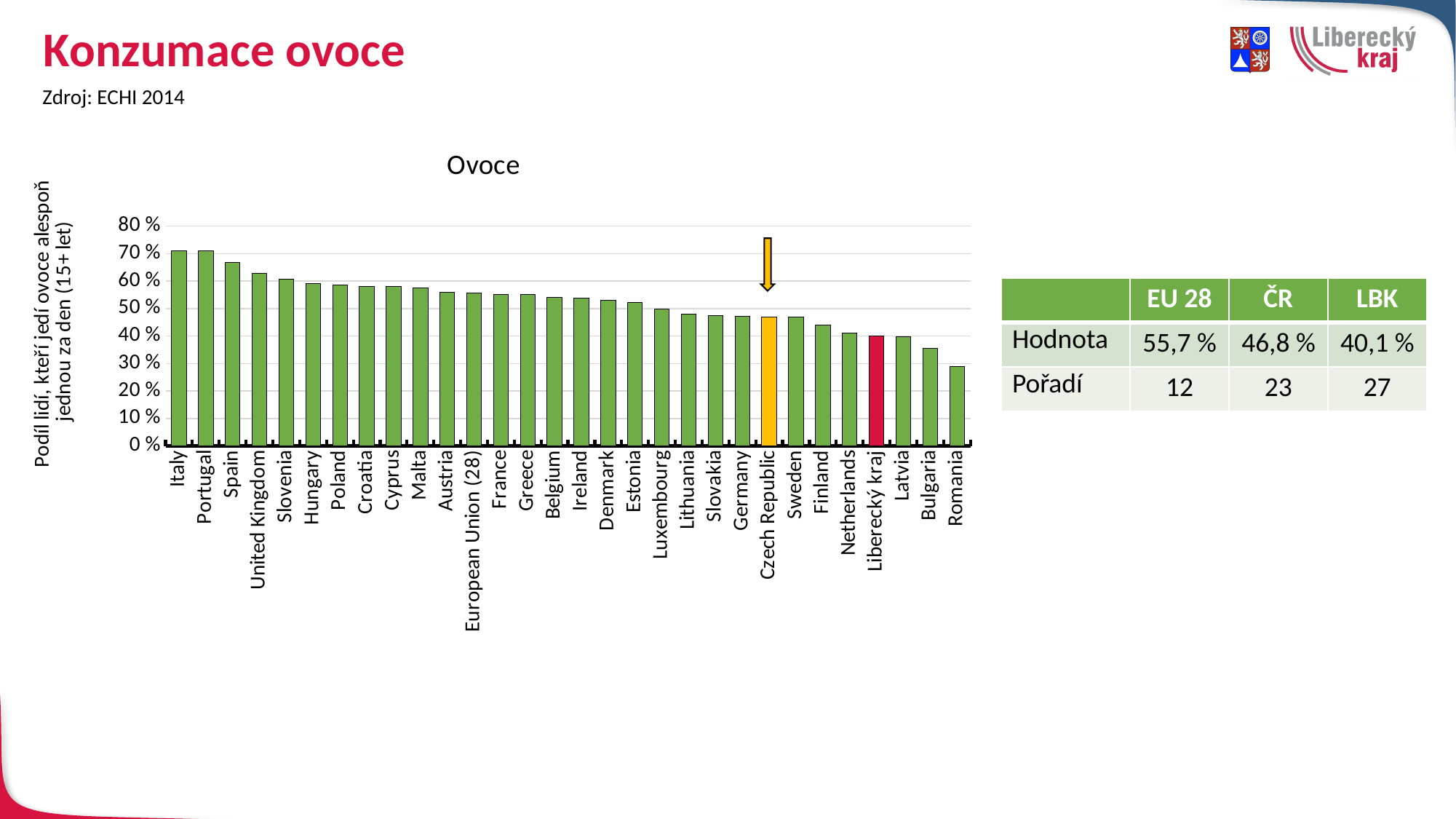
Is the value for Hungary greater or less than 50 %? greater What is the difference between the values for European Union (28) and Czech Republic? 8,9 % What is the value for Czech Republic in the Ovoce chart? 46,8 % Do the values rise or fall from left to right along the x axis? fall What is the value for European Union (28) in the Ovoce chart? 55,7 % Which has a larger value, Spain or Germany? Spain How many categories are shown on the x axis of the Ovoce chart? 30 What is the value for Liberecký kraj in the Ovoce chart? 40,1 % Is the value for Bulgaria greater or less than 40 %? less What type of chart is shown on the slide? bar chart Which category has the lowest value in the Ovoce chart? Romania What is the difference between the values for Czech Republic and Liberecký kraj? 6,7 %